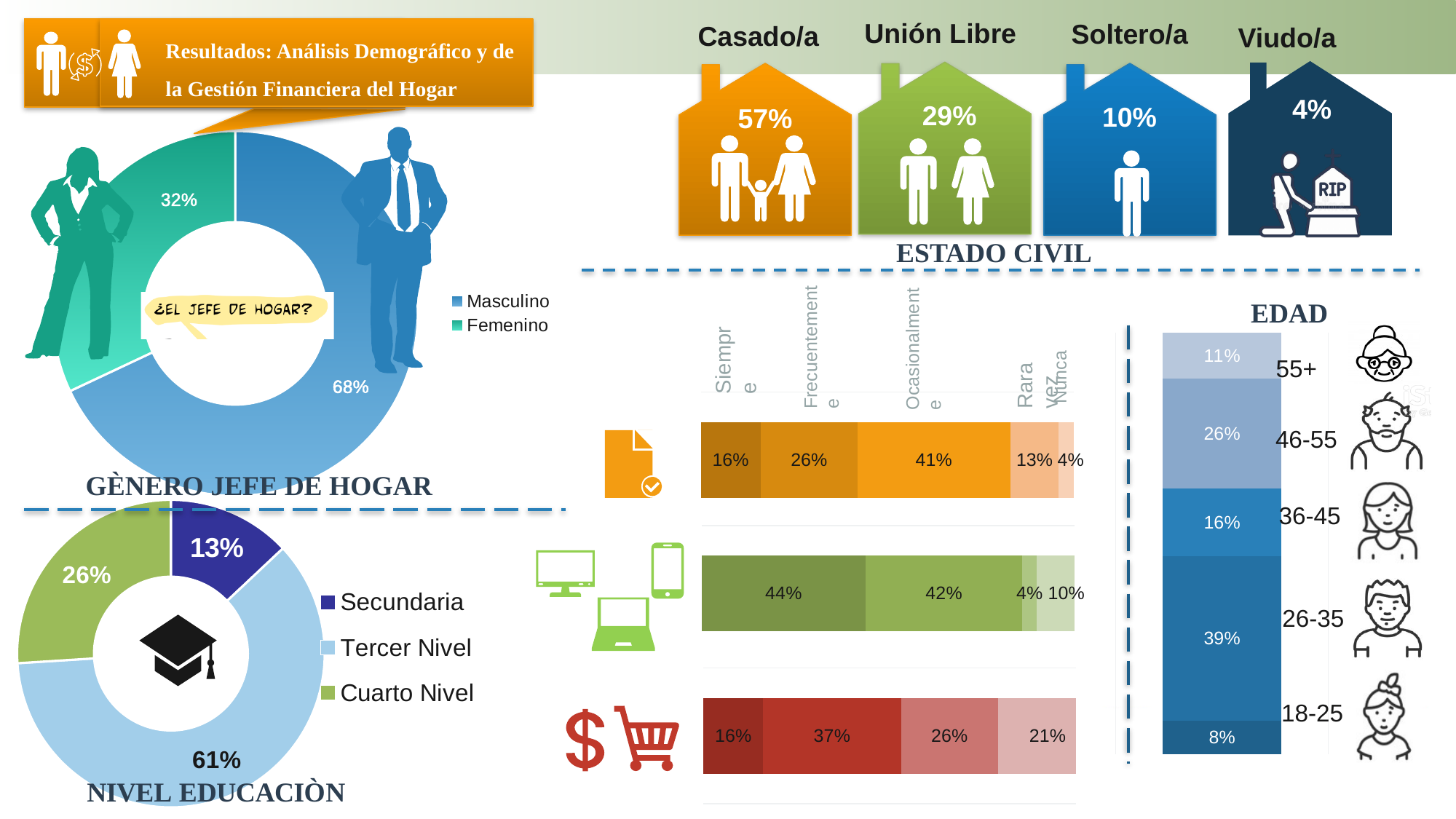
In the GÈNERO JEFE DE HOGAR chart, what percentage is Masculino? 68% In the ESTADO CIVIL section, which category has the lowest percentage? Viudo/a In the ESTADO CIVIL section, what percentage is Unión Libre? 29% In the EDAD chart, what is the value for the 26-35 age group? 39% In the NIVEL EDUCACIÒN chart, what is the value for Cuarto Nivel? 26% In the orange stacked bar of the frequency chart, what is the value for Ocasionalmente? 41% How many categories does the legend of the NIVEL EDUCACIÒN chart list? 3 In the GÈNERO JEFE DE HOGAR chart, what percentage is Femenino? 32% In the EDAD chart, which age group has the smallest share? 18-25 In the green stacked bar of the frequency chart, which is larger: the first segment (44%) or the second segment (42%)? 44% In the NIVEL EDUCACIÒN chart, which category has the largest share? Tercer Nivel In the NIVEL EDUCACIÒN chart, what is the difference between Tercer Nivel and Secundaria? 48%